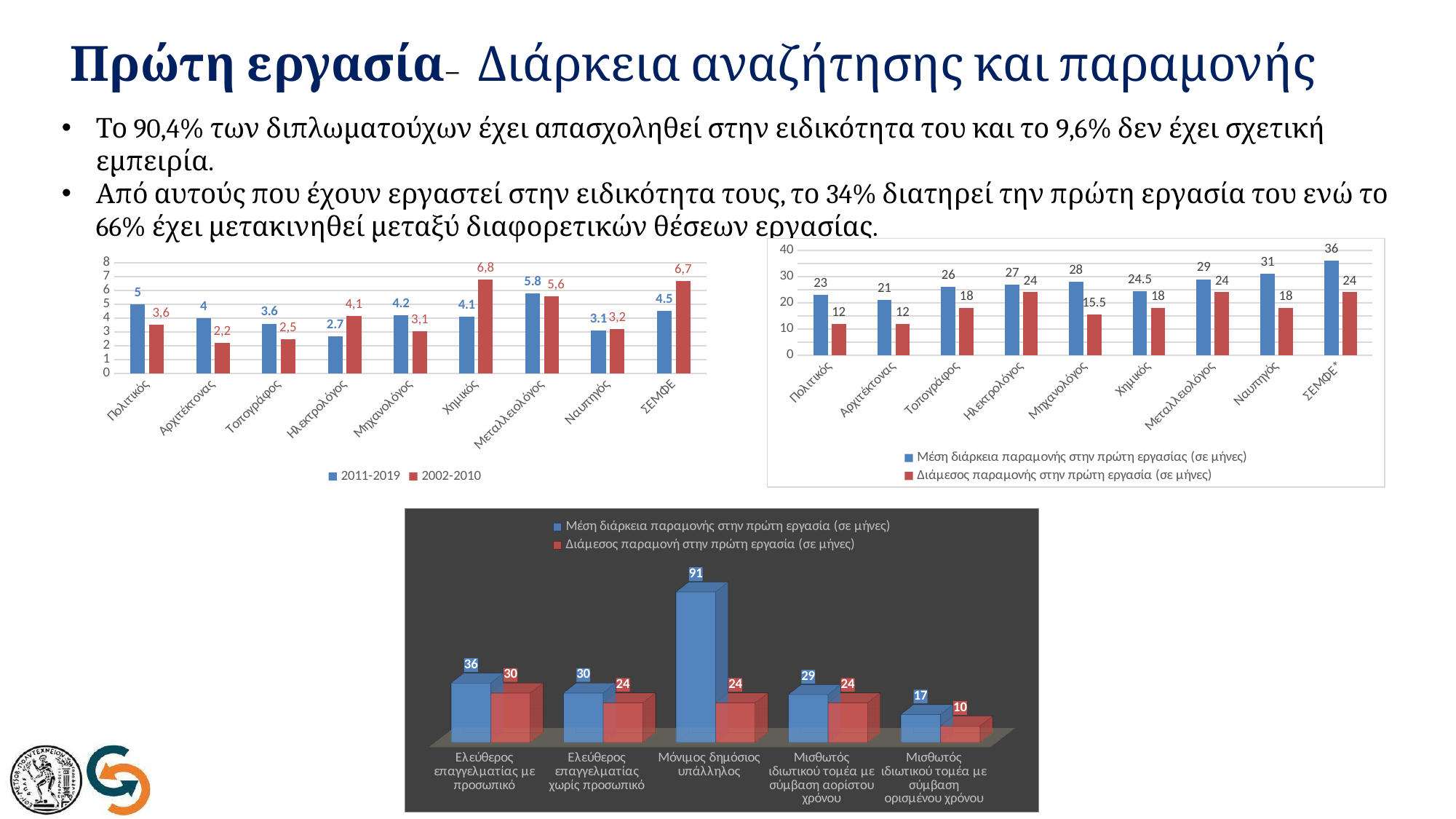
In the top-left chart, how many series does the legend list? 2 In the top-left chart, which category has the highest 2002-2010 value? Χημικός In the top-left chart, which category has the lowest 2011-2019 value? Ηλεκτρολόγος In the top-right chart, which category has the highest Μέση διάρκεια παραμονής στην πρώτη εργασίας (σε μήνες)? ΣΕΜΦΕ* In the top-right chart, what is the Διάμεσος παραμονής στην πρώτη εργασία (σε μήνες) for Μηχανολόγος? 15.5 In the bottom chart, which category has the lowest Διάμεσος παραμονή στην πρώτη εργασία (σε μήνες)? Μισθωτός ιδιωτικού τομέα με σύμβαση ορισμένου χρόνου In the bottom chart, what is the Μέση διάρκεια παραμονής στην πρώτη εργασία (σε μήνες) for Μόνιμος δημόσιος υπάλληλος? 91 In the top-left chart, what is the 2011-2019 value for Μεταλλειολόγος? 5.8 In the bottom chart, how many categories are shown on the x axis? 5 In the top-left chart, what is the 2002-2010 value for Χημικός? 6,8 In the top-right chart, what is the Μέση διάρκεια παραμονής στην πρώτη εργασίας (σε μήνες) for Ναυπηγός? 31 In the top-right chart, what is the difference between the Μέση διάρκεια and the Διάμεσος for Πολιτικός? 11